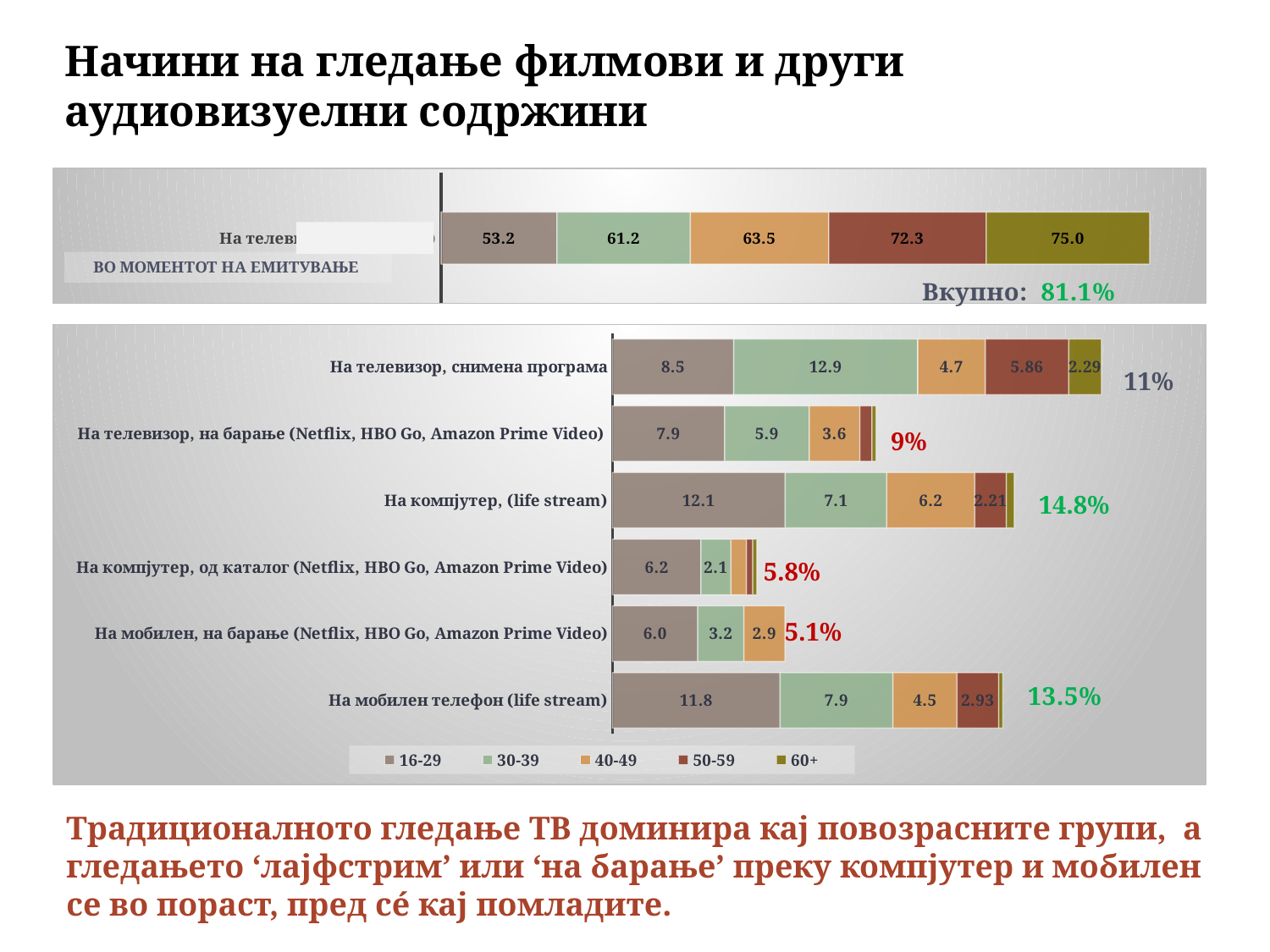
In the bottom chart, which category has the highest percentage label? На компјутер, (life stream) In the bottom chart, what is the 30-39 value for 'На телевизор, снимена програма'? 12.9 In the bottom chart, what is the 16-29 value for 'На компјутер, (life stream)'? 12.1 How many categories are plotted in the bottom chart? 6 In the top chart, what is the total (Вкупно) percentage shown? 81.1% In the bottom chart, what percentage is shown next to the bar for 'На мобилен телефон (life stream)'? 13.5% In the top chart, do the segment values rise or fall from the 16-29 group to the 60+ group? rise In the top chart, what is the value of the rightmost (60+) segment? 75.0 In the top chart, what is the value of the leftmost (16-29) segment? 53.2 In the bottom chart, what is the difference between the 16-29 values for 'На компјутер, (life stream)' and 'На мобилен телефон (life stream)'? 0.3 How many series does the legend of the bottom chart list? 5 In the bottom chart, which category has the lowest percentage label? На мобилен, на барање (Netflix, HBO Go, Amazon Prime Video)